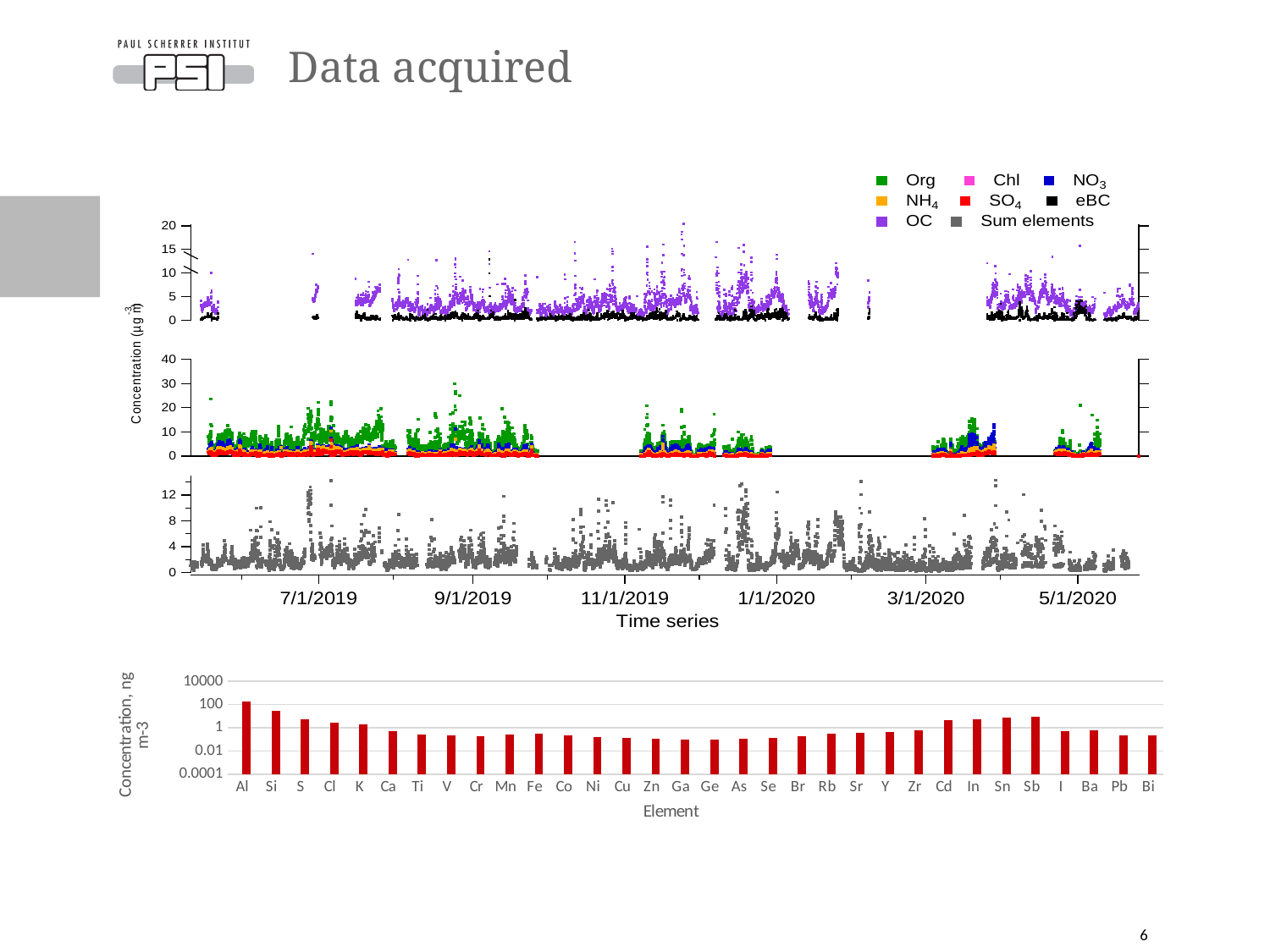
In the bottom chart, is the value for Al greater or less than 100? greater In the bottom chart, which has the larger concentration, Al or Si? Al In the bottom chart, which element has the highest concentration? Al In the bottom chart, is the value for Si greater or less than 100? less What is the x-axis title of the top time series chart? Time series In the top time series chart, what colour represents OC in the legend? purple In the bottom chart, is the value for Cd greater or less than 1? greater How many series does the legend of the top time series chart list? 8 What kind of chart is the bottom chart with the element concentrations? bar chart In the bottom chart, which has the larger concentration, Sb or Pb? Sb How many elements are shown on the x axis of the bottom chart? 32